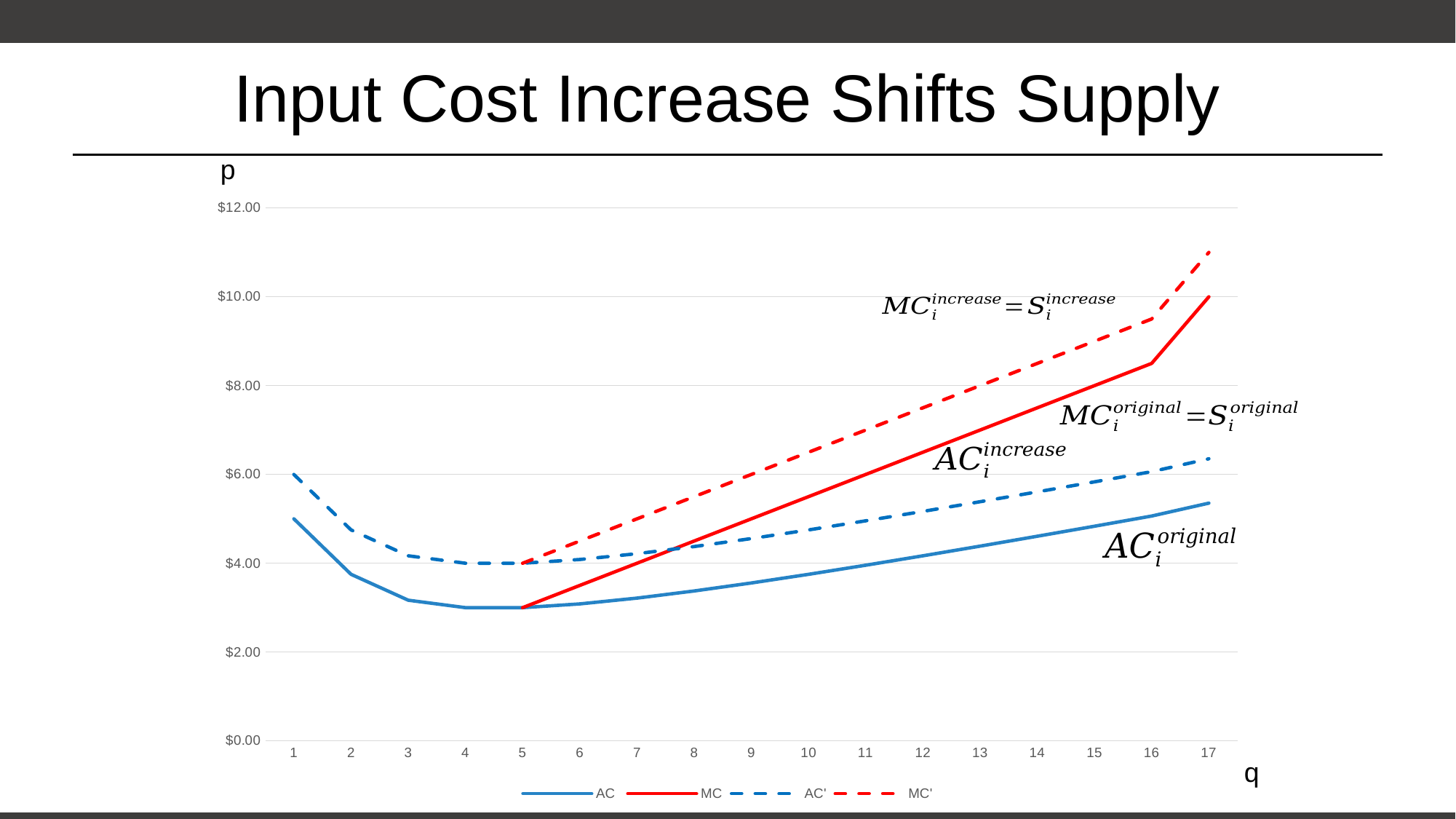
Is the value of the MC' series at q = 17 greater or less than $10.00? greater Is the value of the AC series at q = 17 greater or less than $6.00? less How many points are labelled along the q axis? 17 How many series does the legend list? 4 What kind of chart is shown on the slide? line chart At q = 17, which series has the higher value, MC or MC'? MC' What is the value of the MC' series at q = 5? $4.00 Does the MC series rise or fall as q increases from 5 to 17? rise Is the value of the MC series at q = 16 greater or less than $8.00? greater What is the title of the slide containing the chart? Input Cost Increase Shifts Supply What is the value of the AC' series at q = 1? $6.00 What is the value of the MC series at q = 17? $10.00